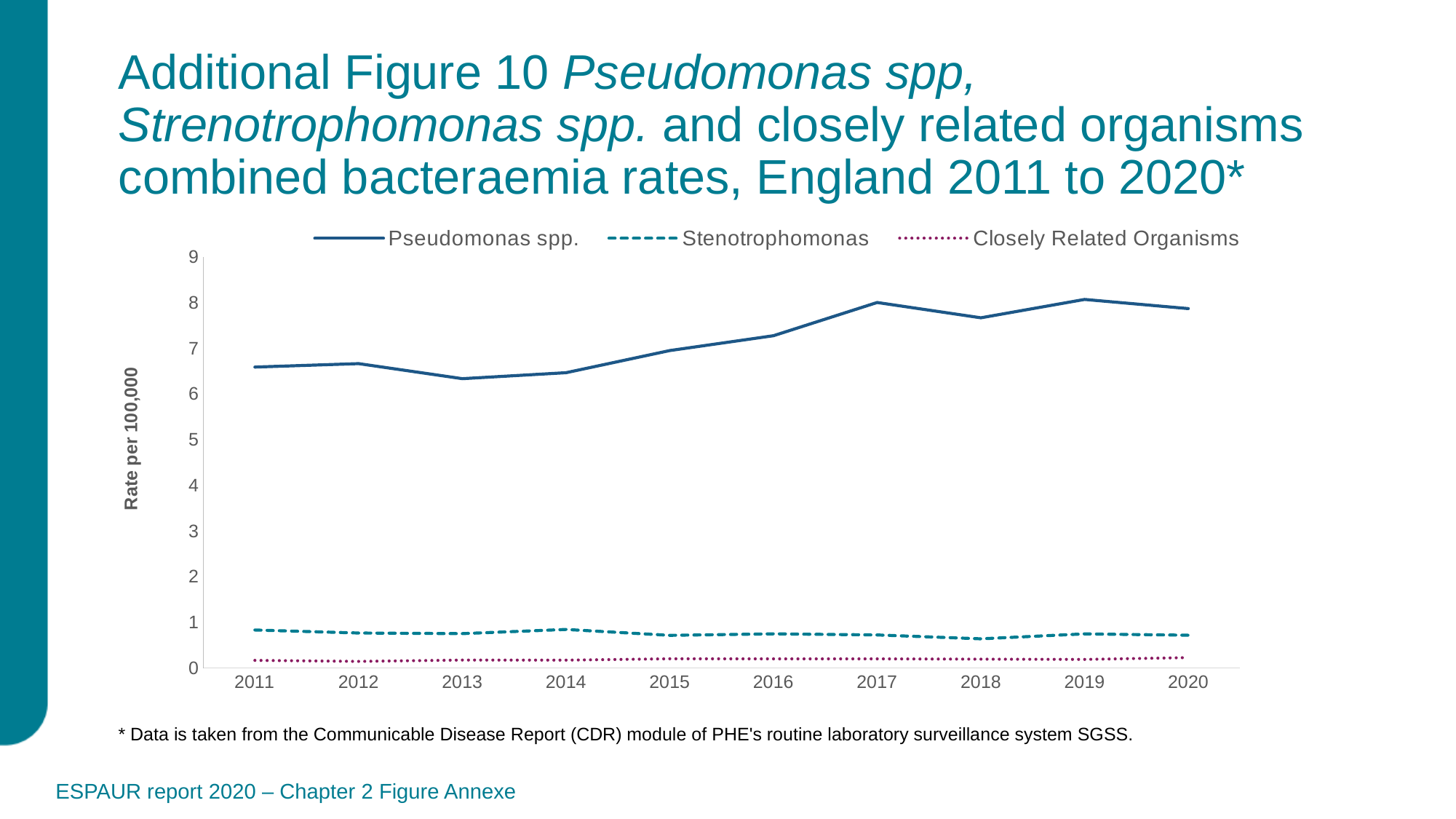
What is the label on the y axis? Rate per 100,000 Does the Pseudomonas spp. line rise or fall between 2013 and 2017? Rise Which series has the higher value in 2020, Pseudomonas spp. or Closely Related Organisms? Pseudomonas spp. How many years are plotted along the x axis? 10 How many series does the legend list? 3 Which series has the lowest values across all years? Closely Related Organisms Is the value for Stenotrophomonas in 2015 greater or less than 1? less Is the value for Pseudomonas spp. in 2011 greater or less than 7? less Is the value for Pseudomonas spp. in 2017 greater or less than 7? greater Which series is drawn with a dotted line? Closely Related Organisms What kind of chart is shown on the slide? Line chart